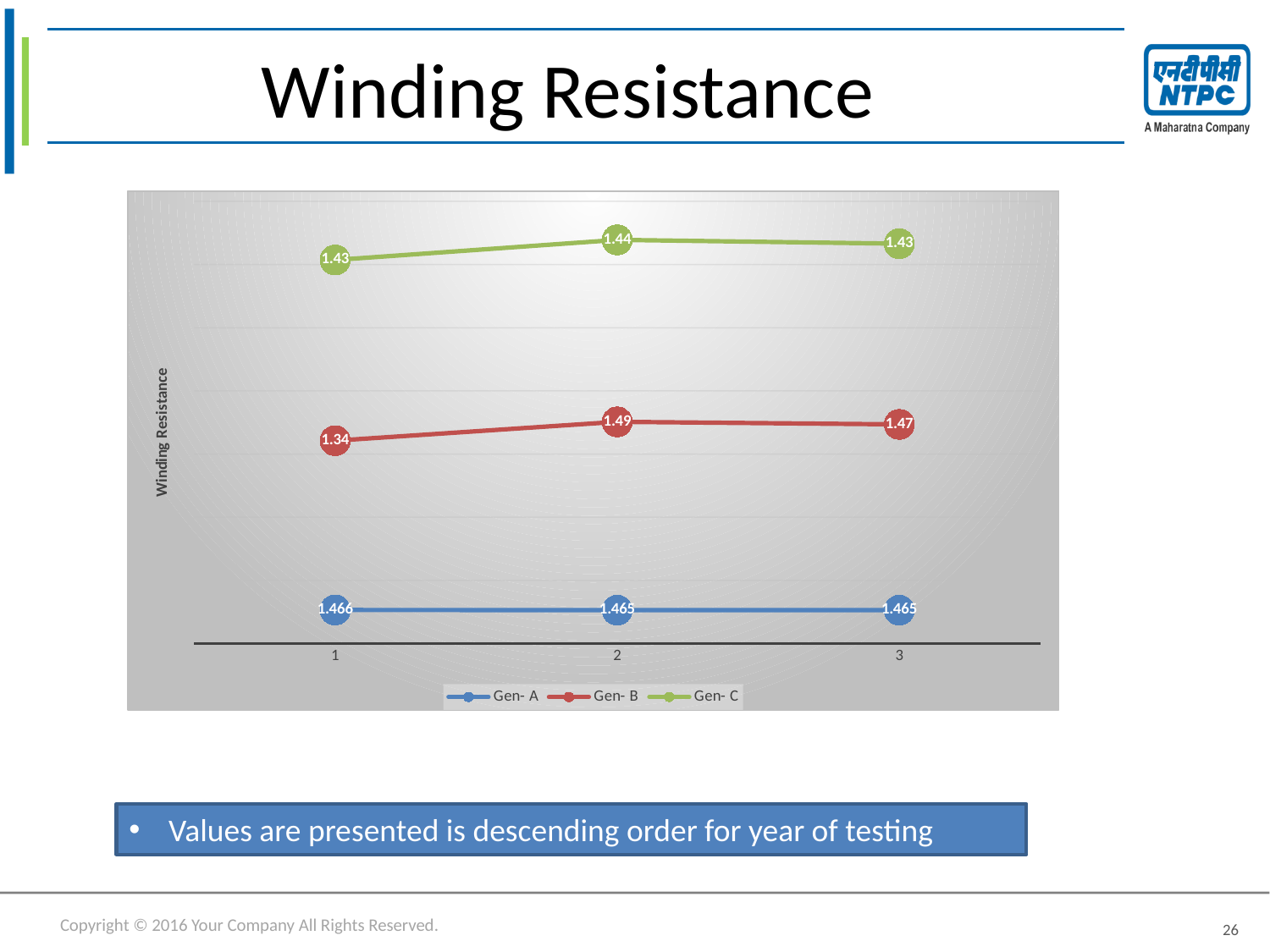
Does the value for Gen- B rise or fall from x = 1 to x = 2? rise At which x value does Gen- B reach its highest value? 2 What is the value for Gen- A at x = 1? 1.466 Which is larger at x = 1: the value for Gen- B or the value for Gen- C? Gen- C What is the difference between the Gen- B values at x = 2 and x = 1? 0.15 At which x value does Gen- B have its lowest value? 1 What is the value for Gen- C at x = 3? 1.43 What kind of chart is shown on the slide? line chart What is the title of the vertical axis? Winding Resistance How many points are plotted along the x axis for each series? 3 How many series does the legend list? 3 What is the value for Gen- B at x = 2? 1.49